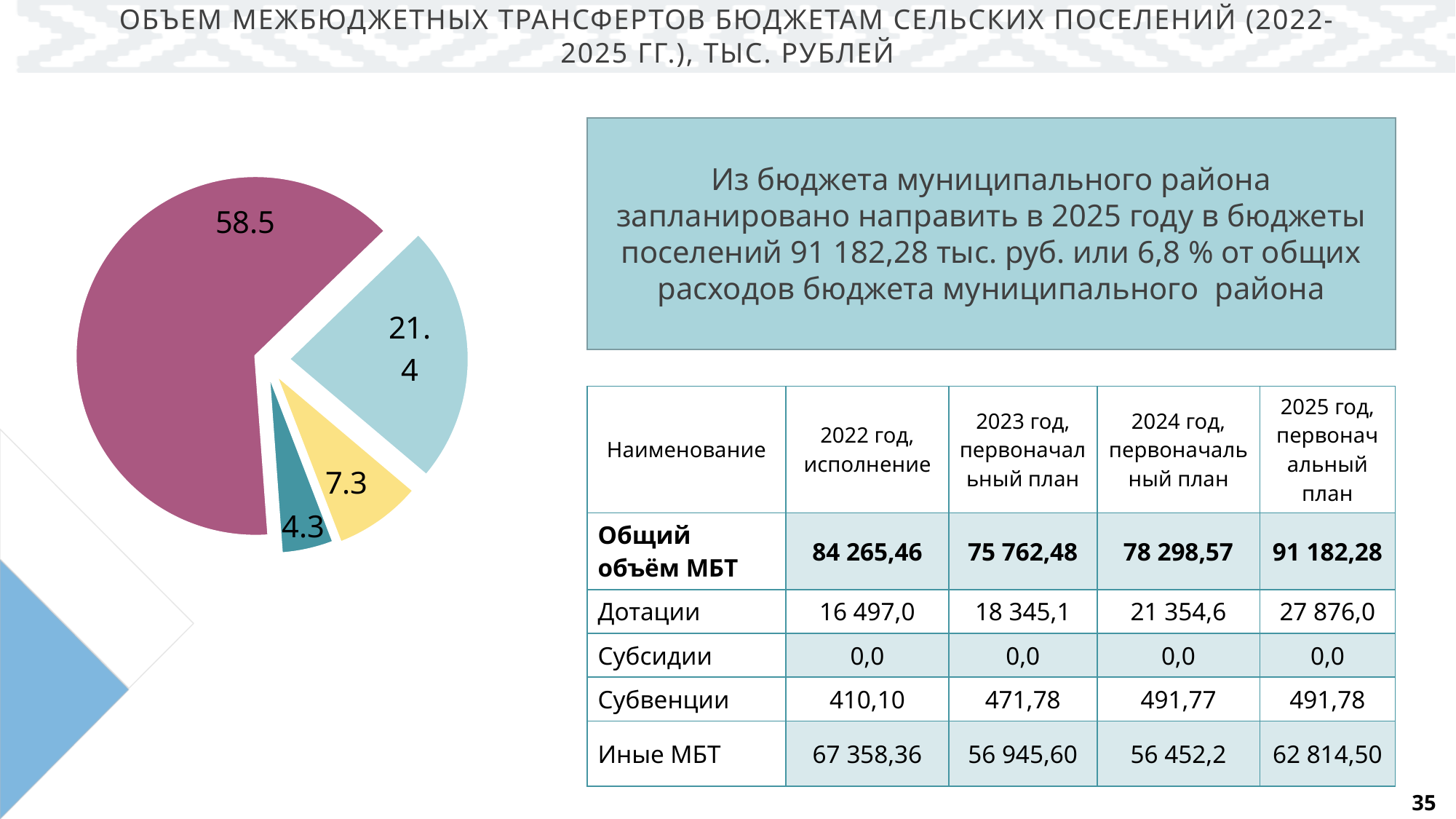
Which slice of the pie chart is larger, the yellow one or the dark teal one? the yellow one What is the difference between the largest slice (58.5) and the smallest slice (4.3) in the pie chart? 54.2 Does the pie chart include a legend identifying the slices? No What is the value labelled on the smallest slice of the pie chart? 4.3 What value is labelled on the dark teal slice of the pie chart? 4.3 What kind of chart is shown on the left of the slide? pie chart What is the value labelled on the largest slice of the pie chart? 58.5 What is the difference between the light blue slice (21.4) and the yellow slice (7.3) in the pie chart? 14.1 What value is labelled on the yellow slice of the pie chart? 7.3 How many slices does the pie chart have? 4 What value is labelled on the magenta (dark pink) slice of the pie chart? 58.5 What value is labelled on the light blue slice of the pie chart? 21.4